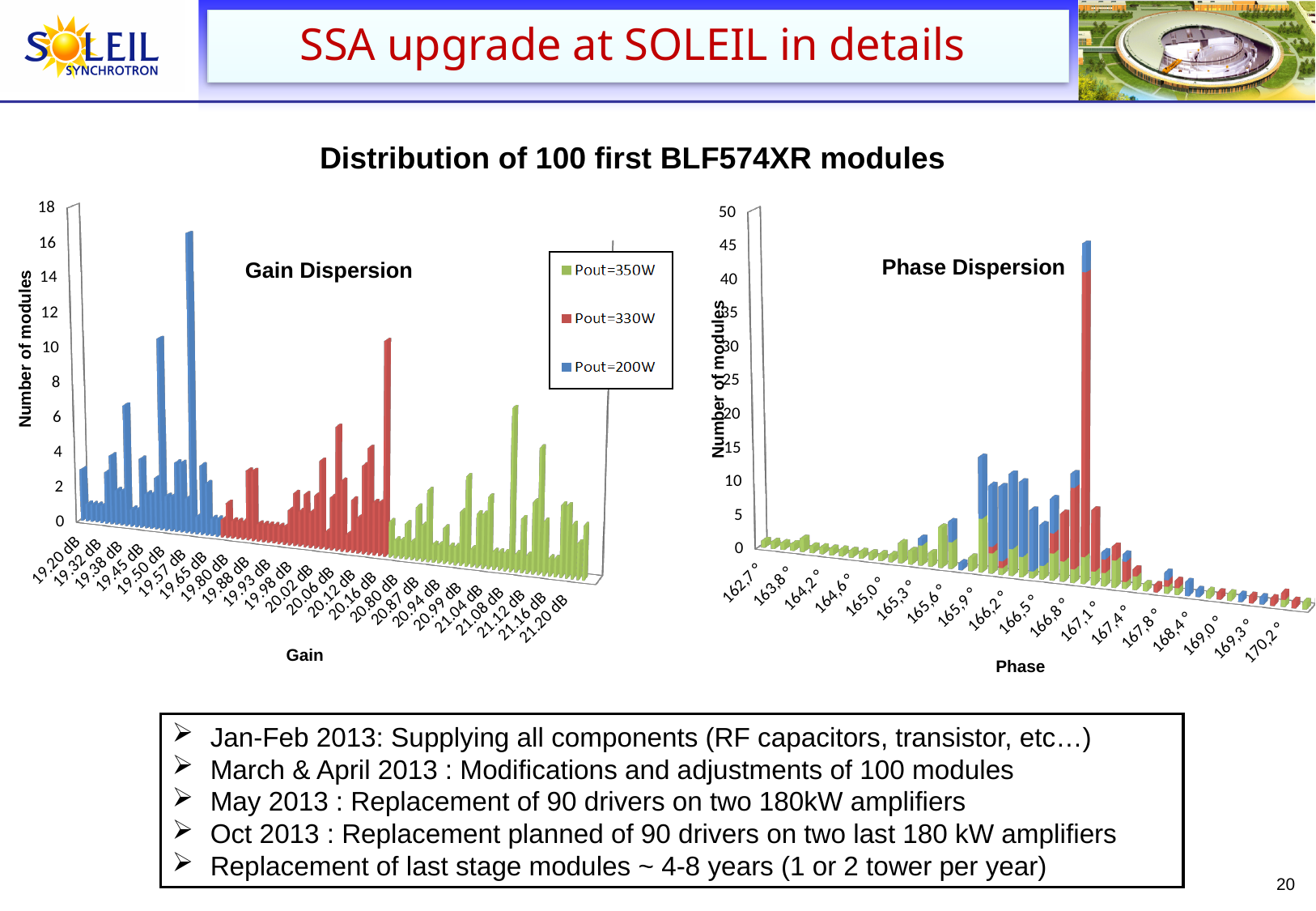
What are the legend entries of the Gain Dispersion chart? Pout=350W, Pout=330W, Pout=200W What kind of chart is the Gain Dispersion chart on the left? bar chart What is the y-axis title of the Gain Dispersion chart? Number of modules How many series does the legend of the Gain Dispersion chart list? 3 In the Gain Dispersion chart, is the tallest bar greater or less than 14? greater What kind of chart is the Phase Dispersion chart on the right? bar chart In the Gain Dispersion chart, which series has the taller maximum bar, Pout=200W or Pout=330W? Pout=200W In the Phase Dispersion chart, is the tallest bar greater or less than 40? greater In the Gain Dispersion chart, is the tallest Pout=330W bar greater or less than 8? greater In the Gain Dispersion chart, which series contains the tallest bar? Pout=200W